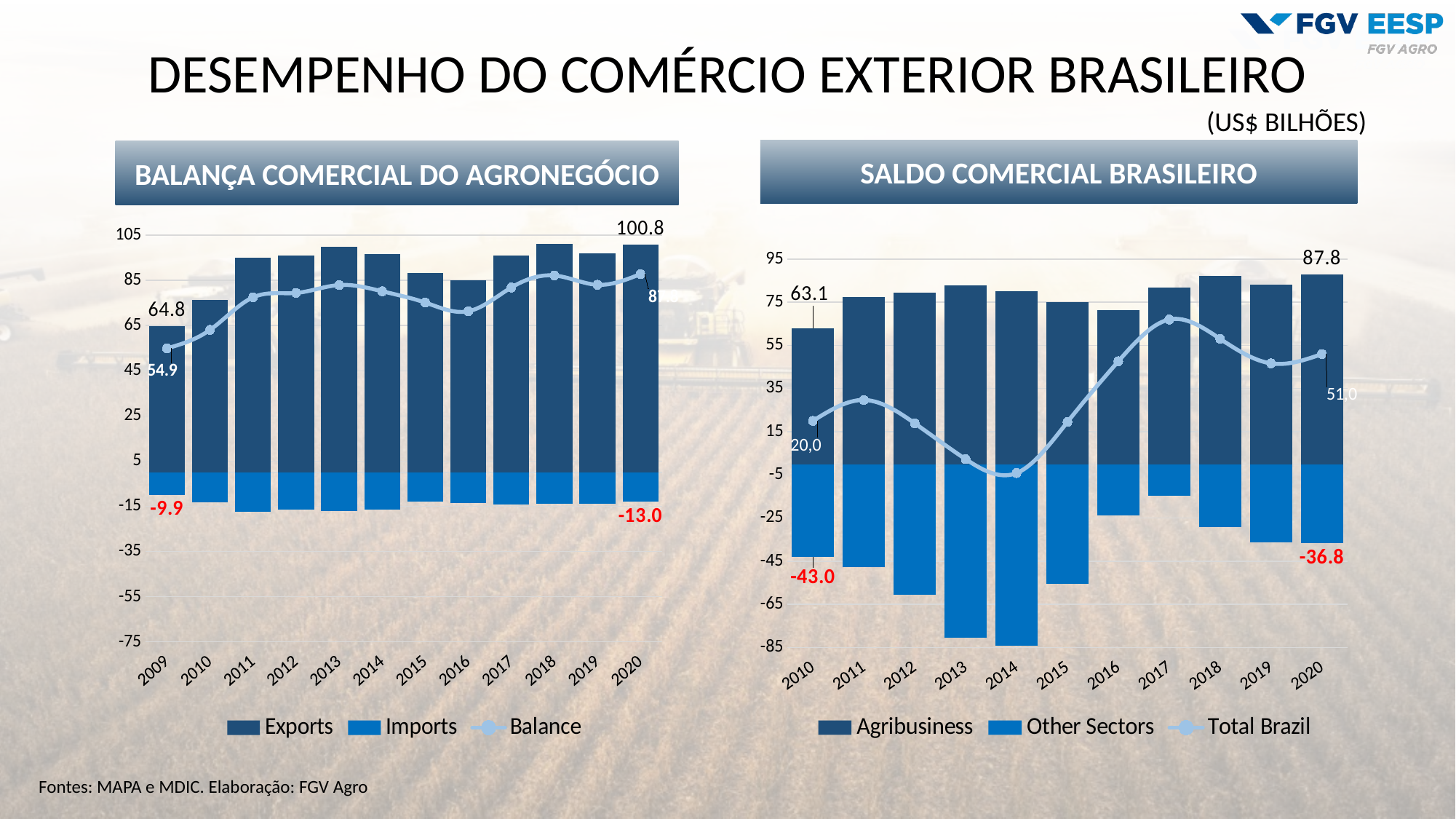
In the BALANÇA COMERCIAL DO AGRONEGÓCIO chart, by how much did Exports in 2020 exceed Exports in 2009? 36.0 In the BALANÇA COMERCIAL DO AGRONEGÓCIO chart, what is the value of Exports in 2020? 100.8 How many years are shown on the x axis of the BALANÇA COMERCIAL DO AGRONEGÓCIO chart? 12 In the BALANÇA COMERCIAL DO AGRONEGÓCIO chart, what is the Balance value in 2009? 54.9 In the SALDO COMERCIAL BRASILEIRO chart, which year has the highest Agribusiness value? 2020 In the BALANÇA COMERCIAL DO AGRONEGÓCIO chart, is the Exports value for 2016 greater or less than 65? greater How many series does the legend of the BALANÇA COMERCIAL DO AGRONEGÓCIO chart list? 3 In the SALDO COMERCIAL BRASILEIRO chart, what is the Agribusiness value in 2010? 63.1 In the SALDO COMERCIAL BRASILEIRO chart, what is the Total Brazil value in 2020? 51,0 In the SALDO COMERCIAL BRASILEIRO chart, what is the Other Sectors value in 2020? -36.8 In the BALANÇA COMERCIAL DO AGRONEGÓCIO chart, what is the value of Exports in 2009? 64.8 In the BALANÇA COMERCIAL DO AGRONEGÓCIO chart, what is the value of Imports in 2020? -13.0